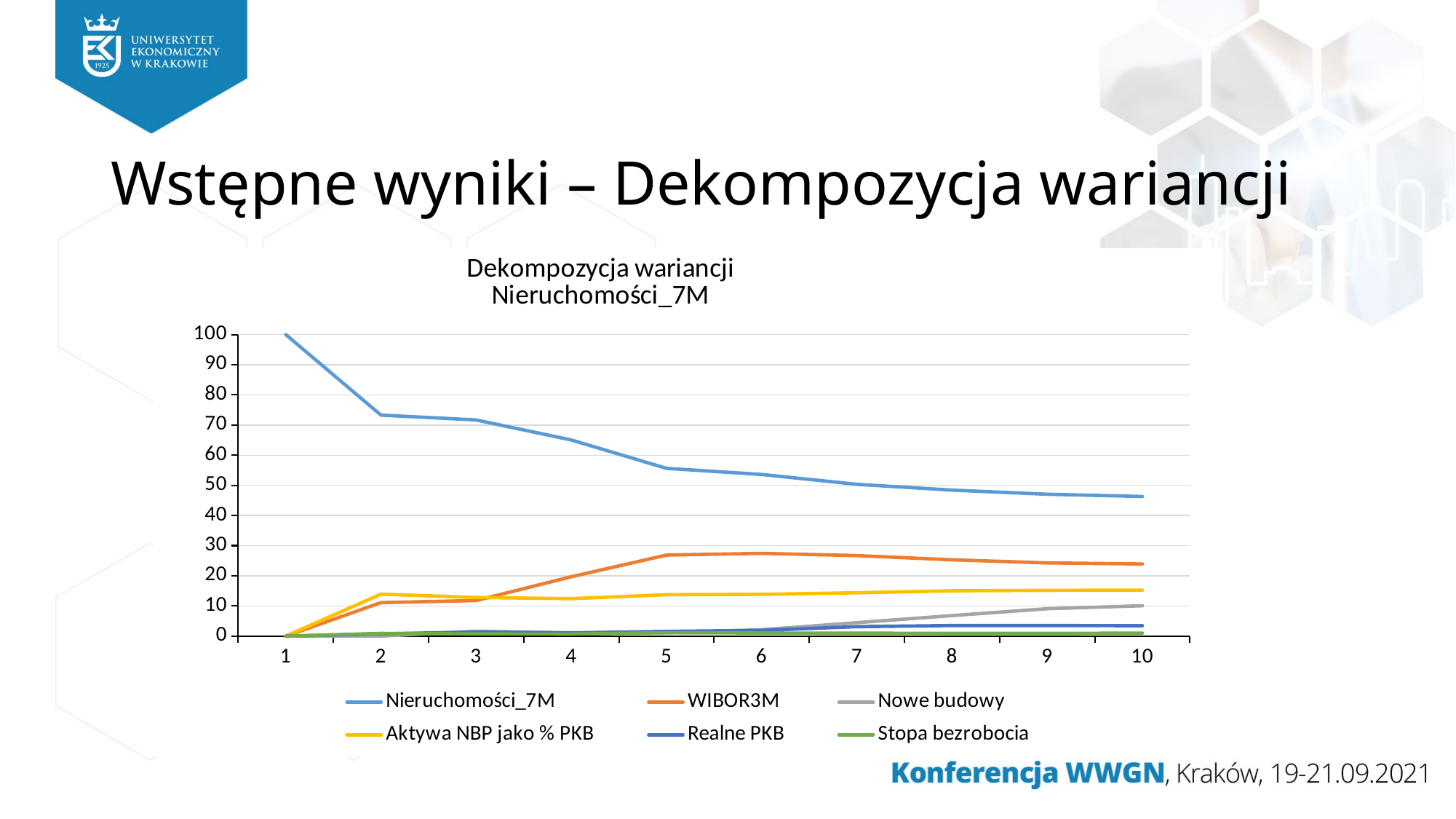
What is the title of the chart? Dekompozycja wariancji Nieruchomości_7M How many points are on the x axis of the chart? 10 At point 10, which is larger: WIBOR3M or Aktywa NBP jako % PKB? WIBOR3M Is the value for Aktywa NBP jako % PKB at point 10 greater or less than 20? less Which series has the highest value at point 10? Nieruchomości_7M What kind of chart is shown on the slide? line chart Is the value for Nieruchomości_7M at point 10 greater or less than 50? less Does the Nieruchomości_7M series rise or fall from point 1 to point 10? fall Is the value for WIBOR3M at point 6 greater or less than 20? greater How many series does the legend list? 6 What is the value of WIBOR3M at point 1? 0 What is the value of Nieruchomości_7M at point 1? 100